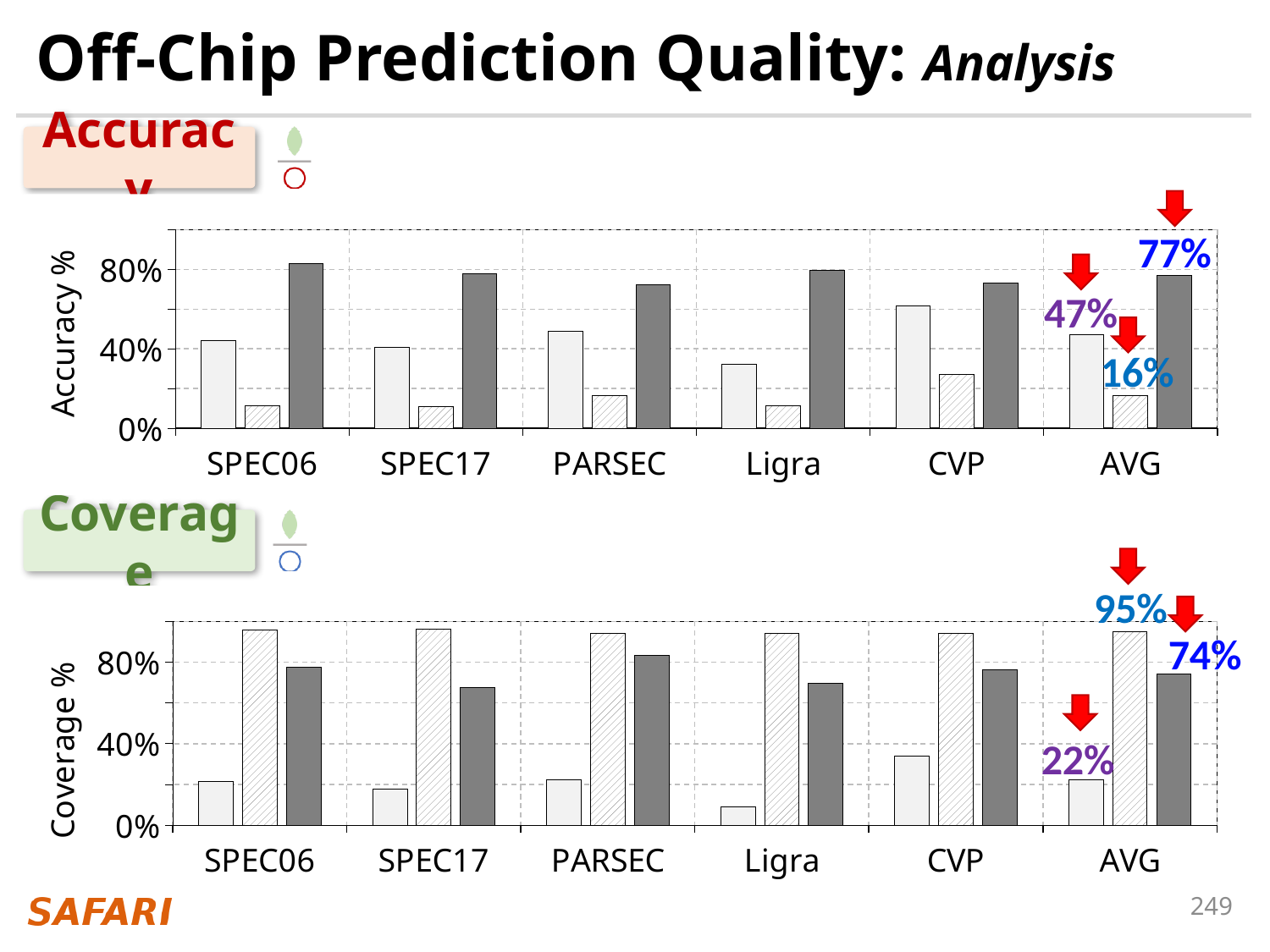
In the Coverage chart, what value is labelled on the first (light) bar for AVG? 22% In the Coverage chart, what value is labelled on the dark gray bar for AVG? 74% What kind of chart is the Accuracy chart at the top of the slide? bar chart In the Accuracy chart, what is the difference between the dark gray AVG bar (77%) and the light AVG bar (47%)? 30% In the Coverage chart, is the value of the first (light) bar for Ligra greater or less than 40%? less In the Accuracy chart, what value is labelled on the hatched bar for AVG? 16% In the Coverage chart, what value is labelled on the hatched bar for AVG? 95% How many categories are shown on the x axis of the Coverage chart? 6 In the Accuracy chart, which is larger: the first (light) bar for CVP or the first (light) bar for SPEC06? CVP In the Accuracy chart, what value is labelled on the first (light) bar for AVG? 47% In the Accuracy chart, what value is labelled on the dark gray bar for AVG? 77% What is the y-axis label of the top chart? Accuracy %